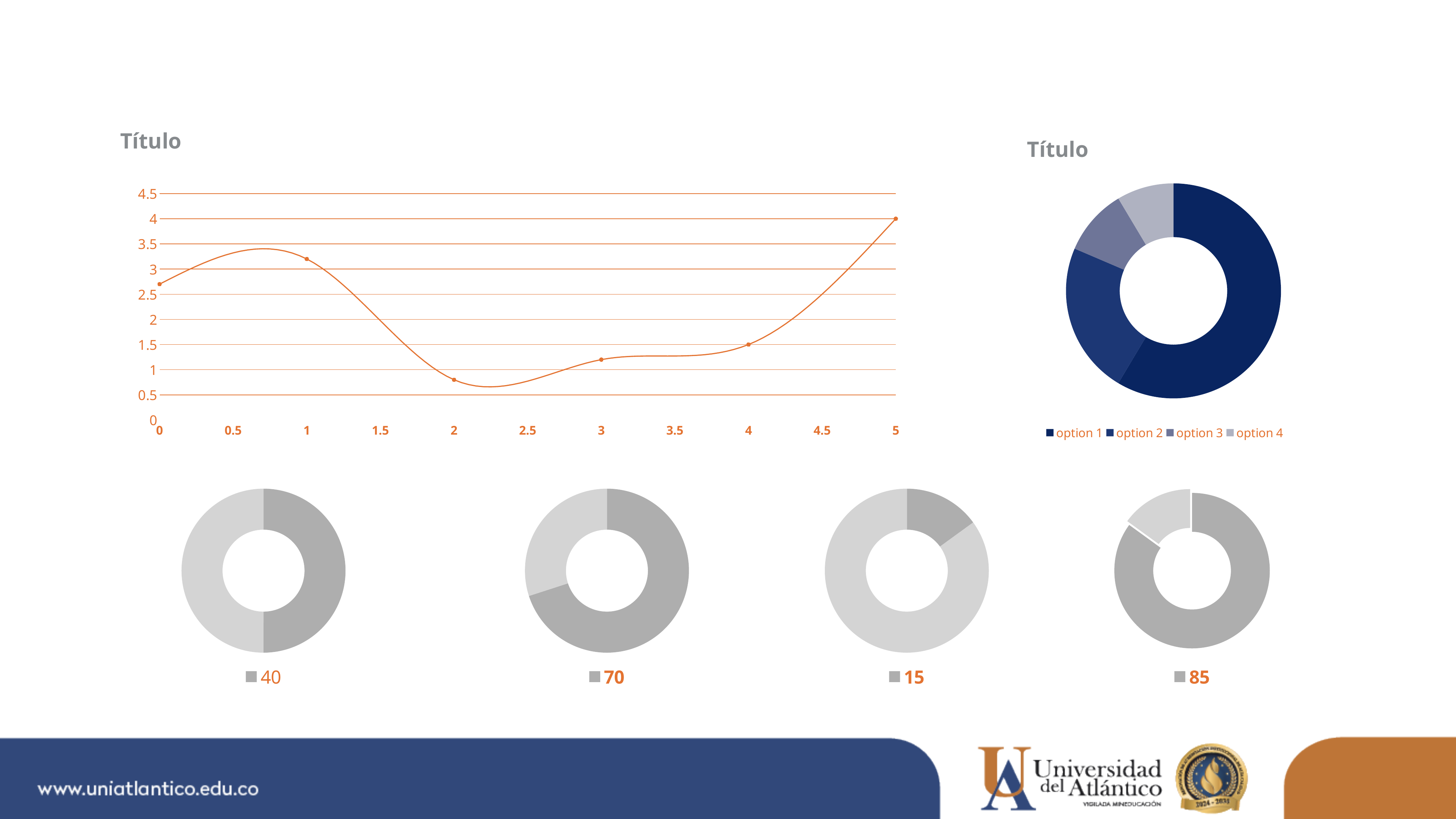
What kind of chart is the chart on the top right of the slide? doughnut chart In the line chart on the top left, how many data points are plotted? 6 In the line chart on the top left, is the value at x = 2 greater or less than 1? less In the doughnut chart on the top right, which option has the largest slice? option 1 In the line chart on the top left, is the value at x = 1 greater or less than 3? greater In the line chart on the top left, at which x value is the plotted value highest? 5 In the line chart on the top left, which is larger, the value at x = 0 or the value at x = 3? x = 0 What kind of chart is the chart on the top left of the slide? line chart In the line chart on the top left, what is the value at x = 5? 4 In the line chart on the top left, do the values rise or fall from x = 2 to x = 5? rise In the doughnut chart on the top right, how many entries does the legend list? 4 In the line chart on the top left, at which x value is the plotted value lowest? 2